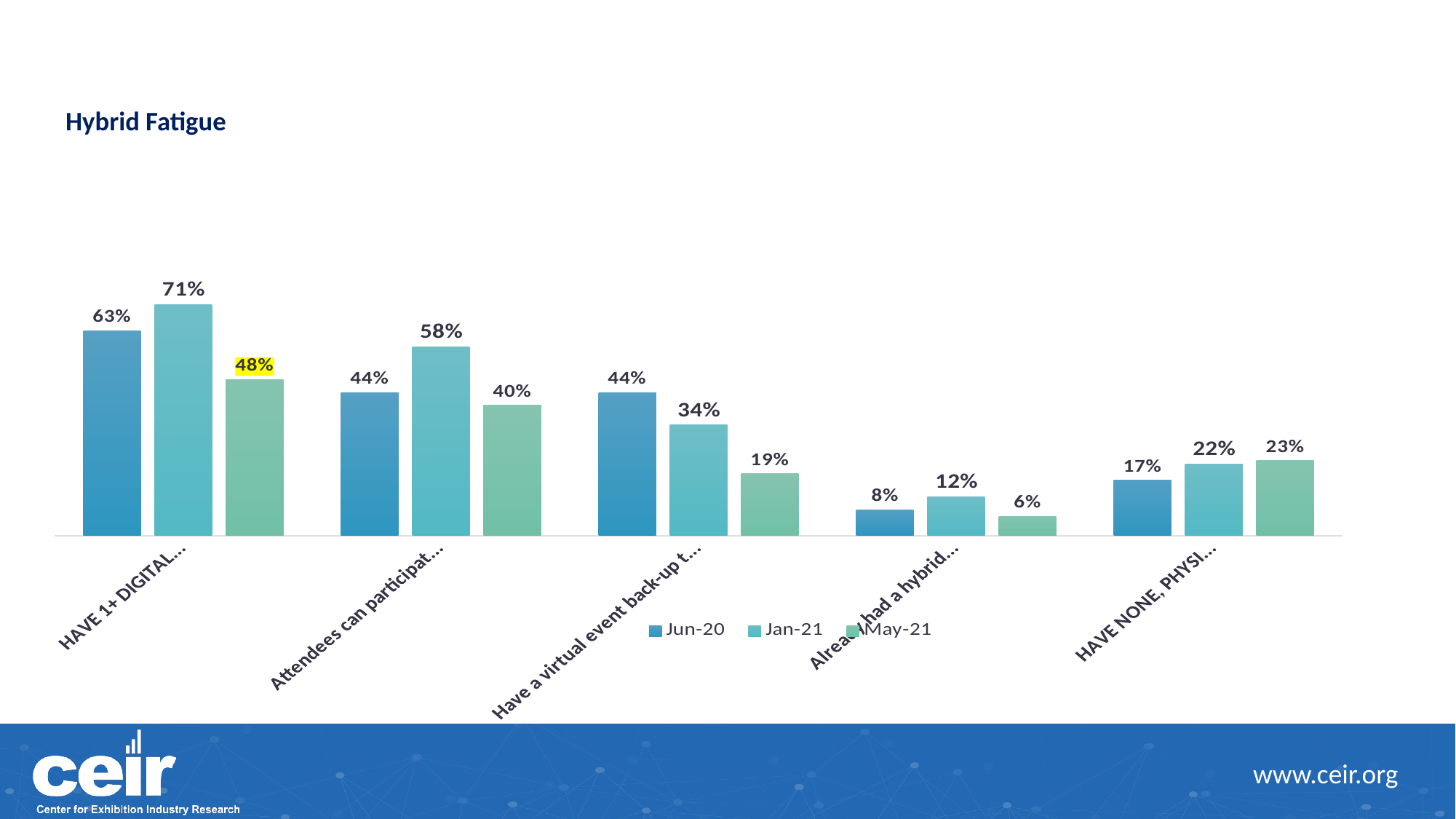
What is the Jun-20 value for the category beginning "HAVE NONE, PHYSI"? 17% What is the May-21 value for the category beginning "Have a virtual event back-up"? 19% What is the title of the chart? Hybrid Fatigue What is the Jan-21 value for the category beginning "HAVE 1+ DIGITAL"? 71% What is the difference between the Jan-21 and May-21 values for the category beginning "HAVE 1+ DIGITAL"? 23% For the category beginning "Have a virtual event back-up", do the values rise or fall from Jun-20 to May-21? fall Which category has the highest Jan-21 value? HAVE 1+ DIGITAL... How many categories are shown on the x axis? 5 How many series does the legend list? 3 What type of chart is shown on the slide? bar chart For the category beginning "Attendees can participat", which is larger: the Jun-20 value or the Jan-21 value? Jan-21 Which category has the lowest May-21 value? Already had a hybrid...